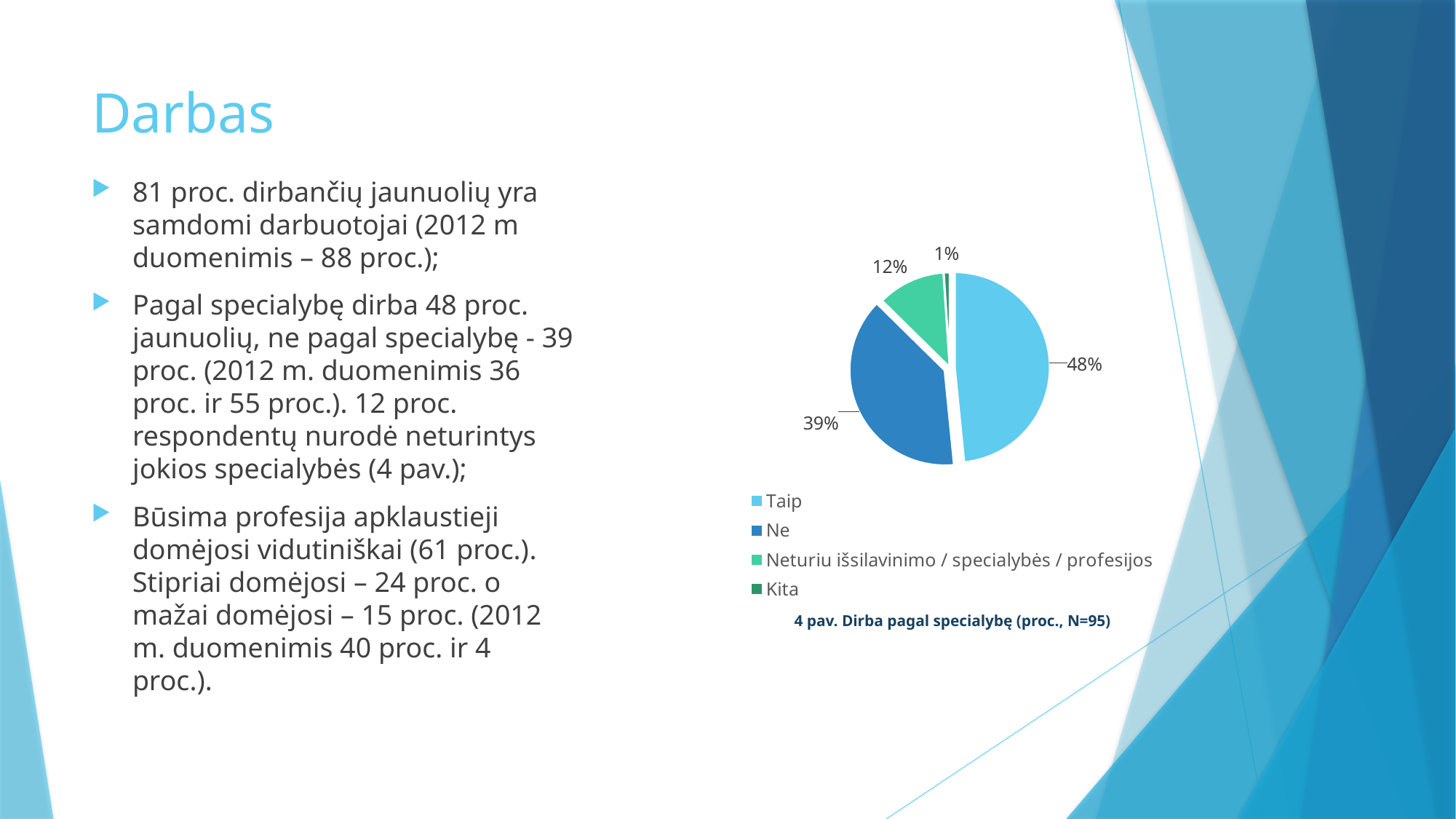
What percentage of the pie is labelled "Ne"? 39% Which category has the smallest slice of the pie? Kita What is the difference in percentage points between the "Taip" and "Ne" slices? 9 What percentage of the pie is labelled "Neturiu išsilavinimo / specialybės / profesijos"? 12% How many categories does the legend of the pie chart list? 4 What percentage of the pie is labelled "Kita"? 1% Which category has the largest slice of the pie? Taip What is the caption printed below the pie chart? 4 pav. Dirba pagal specialybę (proc., N=95) Which slice is larger, "Ne" or "Neturiu išsilavinimo / specialybės / profesijos"? Ne What percentage of the pie is labelled "Taip"? 48% What colour is the "Taip" slice in the pie chart? light blue What type of chart is shown on the slide? pie chart